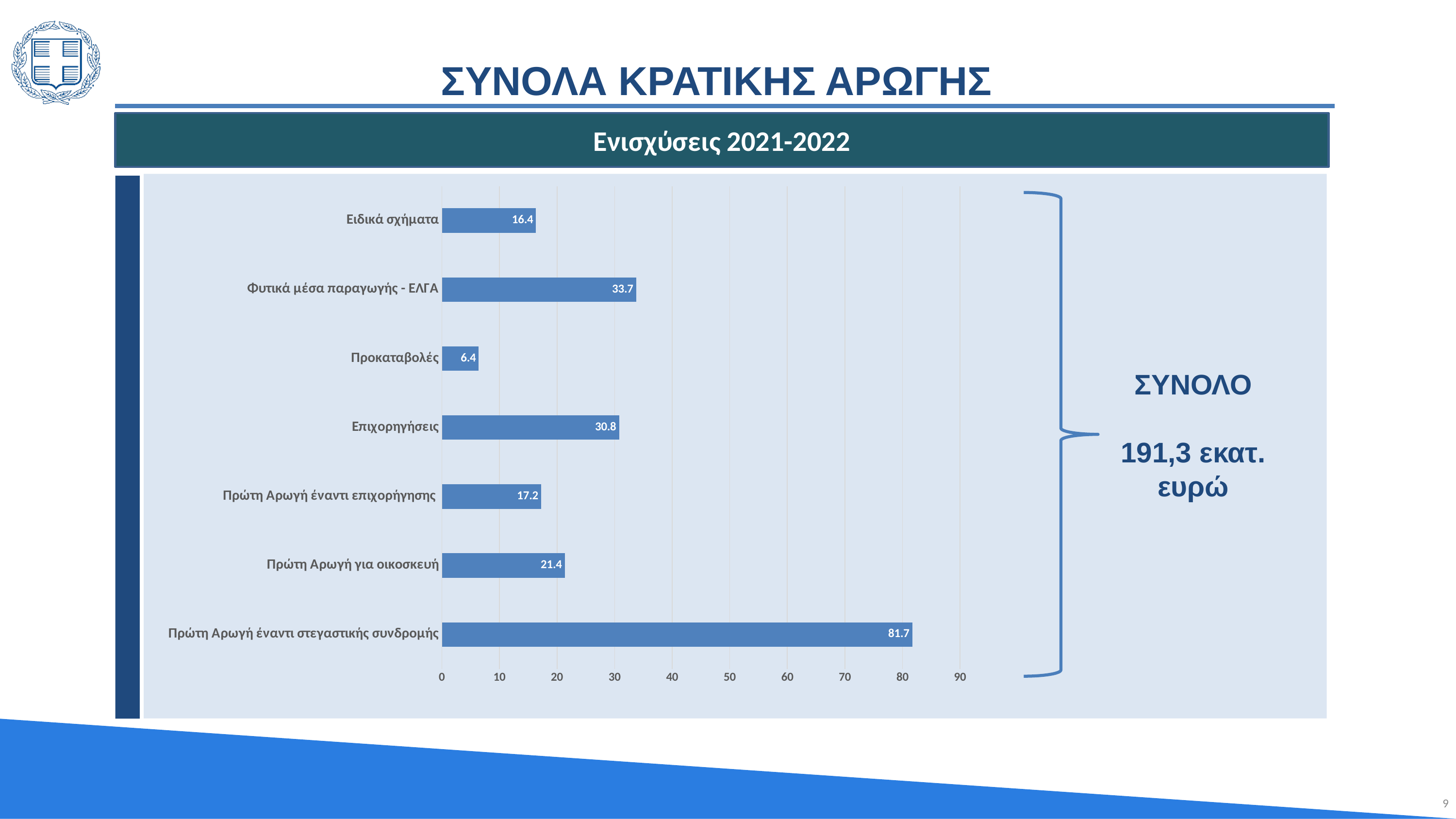
What is the value for Πρώτη Αρωγή για οικοσκευή? 21.4 Which category has the highest value? Πρώτη Αρωγή έναντι στεγαστικής συνδρομής What is the value for Φυτικά μέσα παραγωγής - ΕΛΓΑ? 33.7 Which is larger, the value for Ειδικά σχήματα or the value for Πρώτη Αρωγή έναντι επιχορήγησης? Πρώτη Αρωγή έναντι επιχορήγησης What total is shown next to the bracket to the right of the chart? 191,3 εκατ. ευρώ What kind of chart is shown on the slide? Bar chart What is the difference between the values for Φυτικά μέσα παραγωγής - ΕΛΓΑ and Επιχορηγήσεις? 2.9 What is the value for Πρώτη Αρωγή έναντι στεγαστικής συνδρομής? 81.7 What is the difference between the values for Πρώτη Αρωγή έναντι στεγαστικής συνδρομής and Πρώτη Αρωγή για οικοσκευή? 60.3 How many categories are shown in the chart? 7 Which category has the lowest value? Προκαταβολές What is the value for Προκαταβολές? 6.4